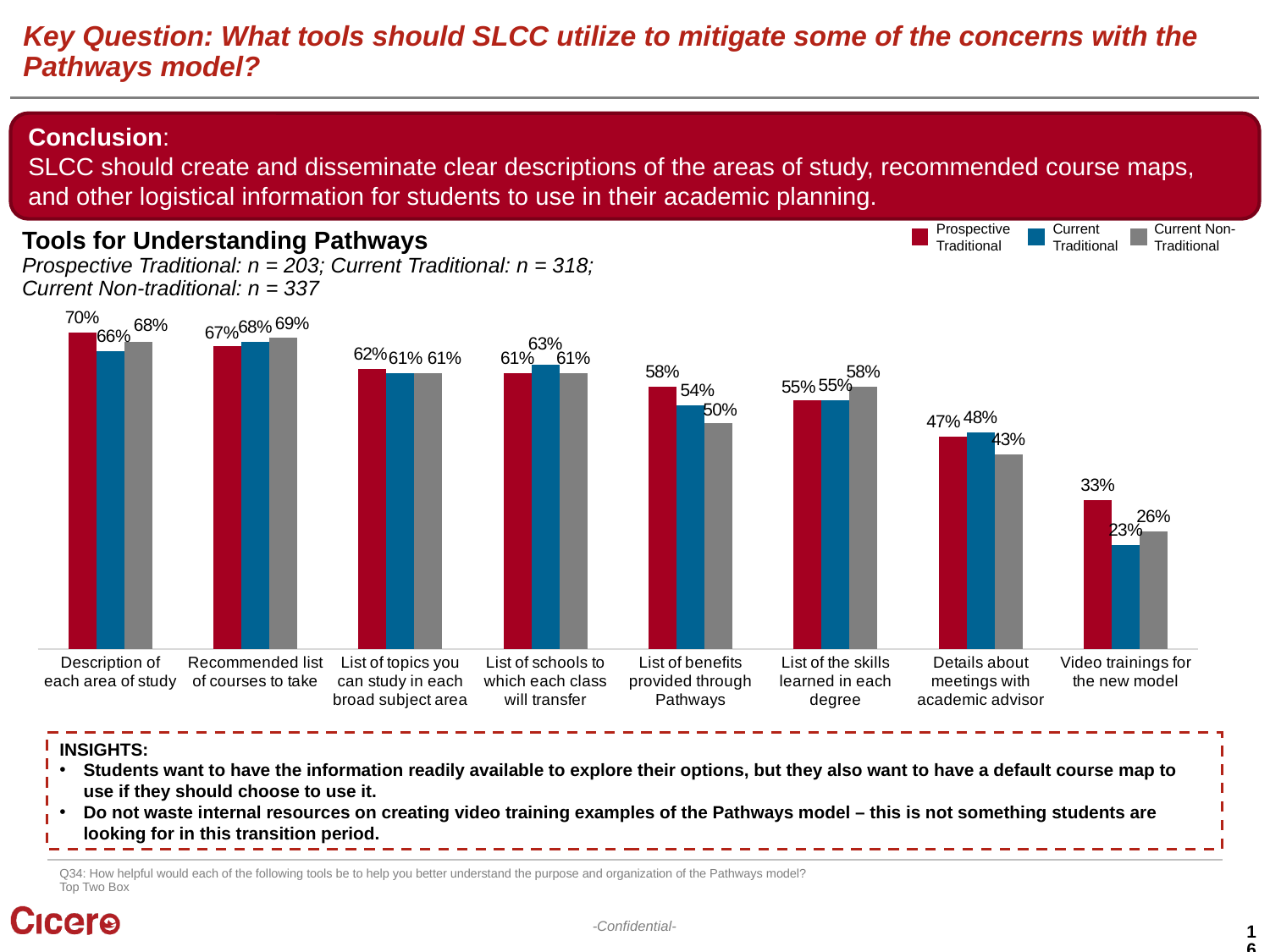
Which category has the lowest Prospective Traditional value? Video trainings for the new model Which series is shown in blue in the legend? Current Traditional What is the Current Non-Traditional value for "List of benefits provided through Pathways"? 50% Which category has the highest Current Non-Traditional value? Recommended list of courses to take How many series does the legend list? 3 What kind of chart is shown on the slide? Bar chart What is the Prospective Traditional value for "Description of each area of study"? 70% What is the title of the chart? Tools for Understanding Pathways For "List of benefits provided through Pathways", which is larger: the Prospective Traditional value or the Current Non-Traditional value? Prospective Traditional What is the difference between the Prospective Traditional and Current Traditional values for "Video trainings for the new model"? 10% How many categories are shown on the x axis of the chart? 8 What is the Current Traditional value for "Video trainings for the new model"? 23%